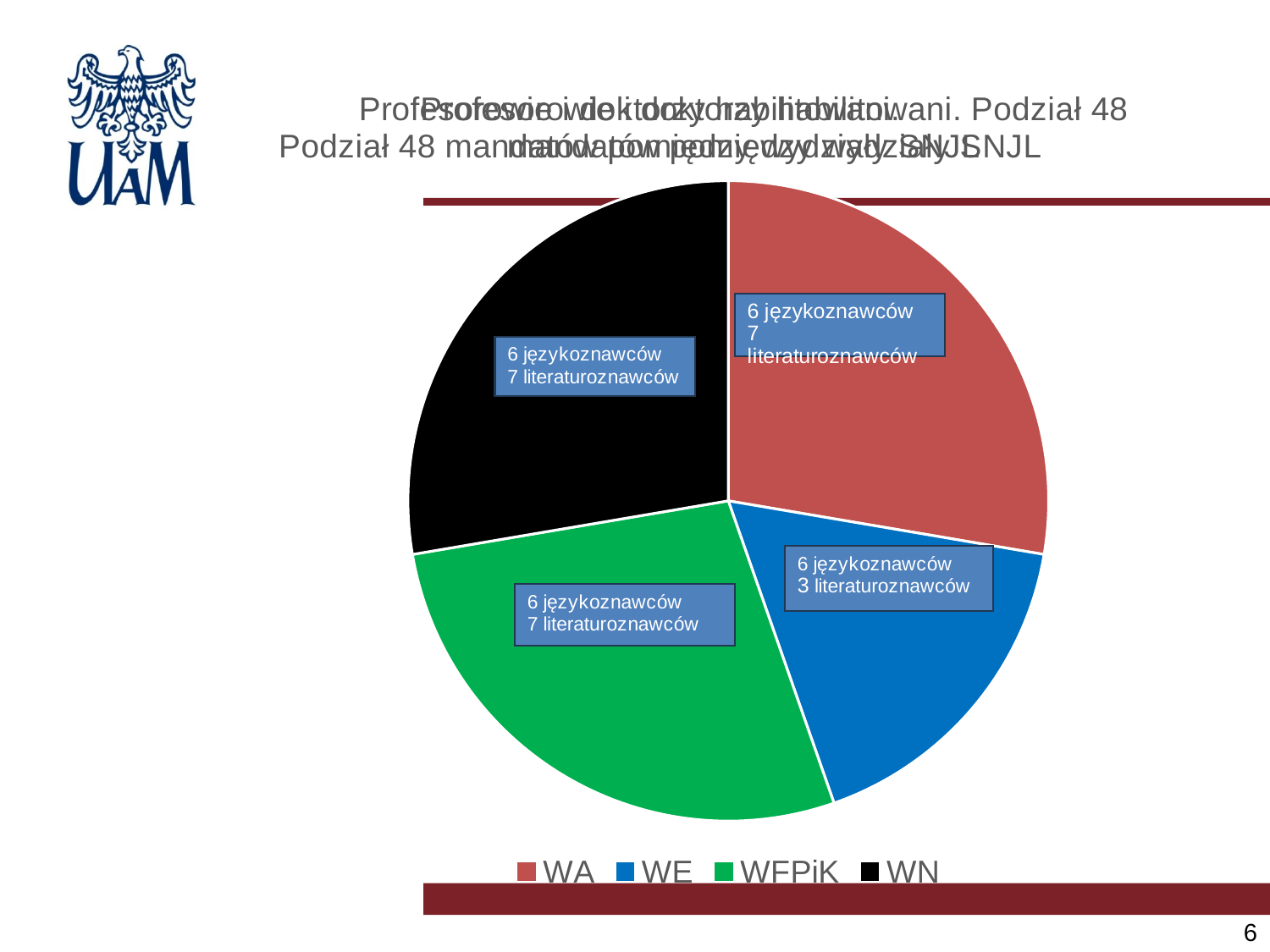
According to its data label, how many językoznawców are in the WE slice? 6 Which slice is larger in the pie chart, WA or WE? WA What is the difference between the number of literaturoznawców in the WA slice and in the WE slice? 4 What colour is the WN slice in the pie chart? black What kind of chart is shown on the slide? pie chart How many slices does the pie chart have? 4 How many entries does the legend of the pie chart list? 4 Which slice of the pie chart is the smallest? WE Which slice is larger in the pie chart, WFPiK or WE? WFPiK According to its data label, how many literaturoznawców are in the WA slice? 7 What colour is the WFPiK slice in the pie chart? green According to its data label, how many literaturoznawców are in the WE slice? 3